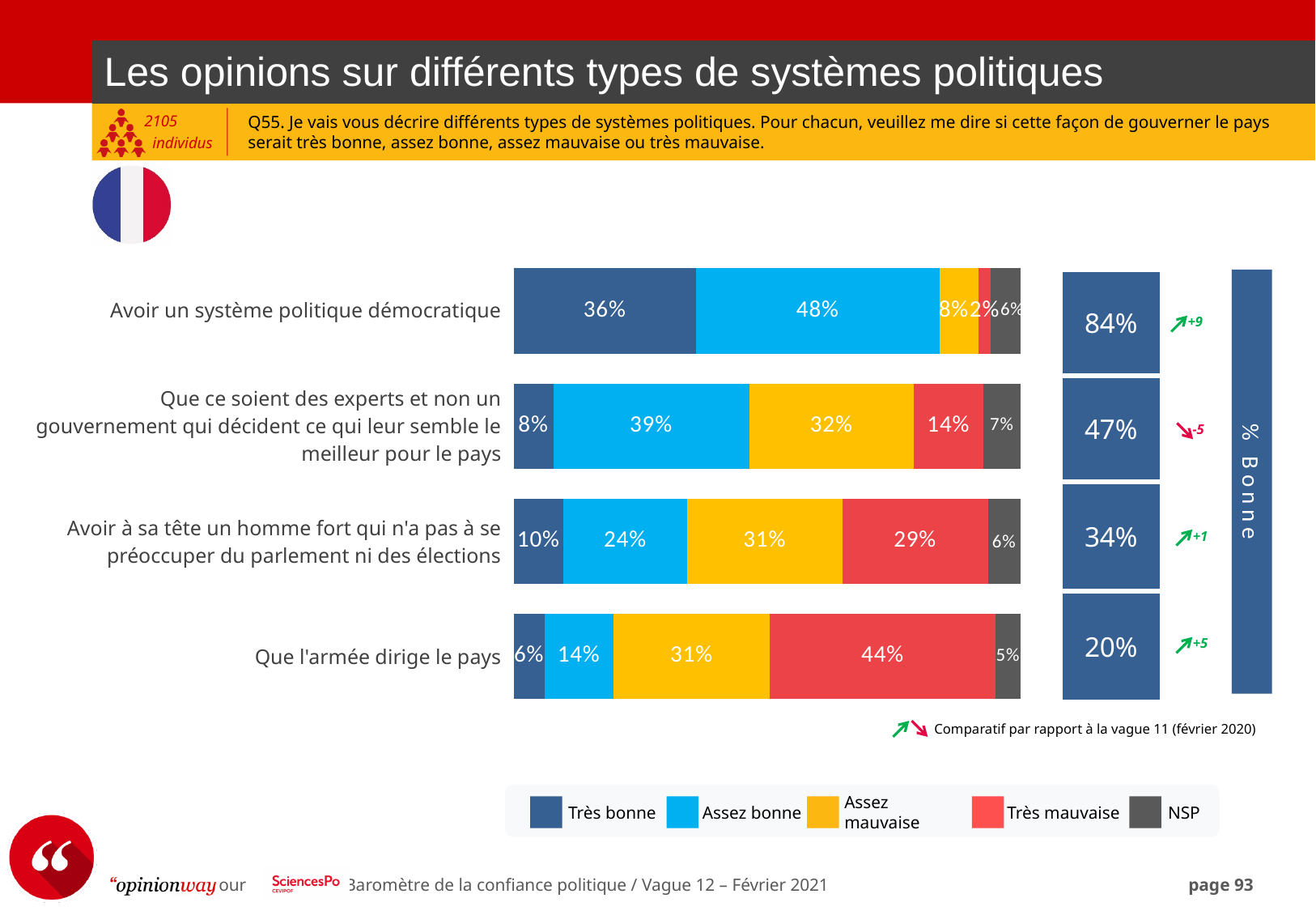
What kind of chart is shown on the slide? Stacked bar chart What is the "Très mauvaise" value for "Que l'armée dirige le pays"? 44% What is the "Assez mauvaise" value for "Que ce soient des experts et non un gouvernement qui décident ce qui leur semble le meilleur pour le pays"? 32% What is the difference between the "Assez bonne" values for "Avoir un système politique démocratique" and "Que l'armée dirige le pays"? 34% Which is larger: the "Très mauvaise" value for "Avoir à sa tête un homme fort..." or for "Que l'armée dirige le pays"? Que l'armée dirige le pays What is the change versus wave 11 shown next to the "% Bonne" value for "Que ce soient des experts..."? -5 How many political systems (categories) are shown in the chart? 4 Which political system has the highest "% Bonne" value? Avoir un système politique démocratique Which political system has the lowest "% Bonne" value? Que l'armée dirige le pays How many series does the legend list? 5 What percentage of respondents said "Très bonne" for "Avoir un système politique démocratique"? 36% What is the "% Bonne" value shown for "Avoir à sa tête un homme fort qui n'a pas à se préoccuper du parlement ni des élections"? 34%